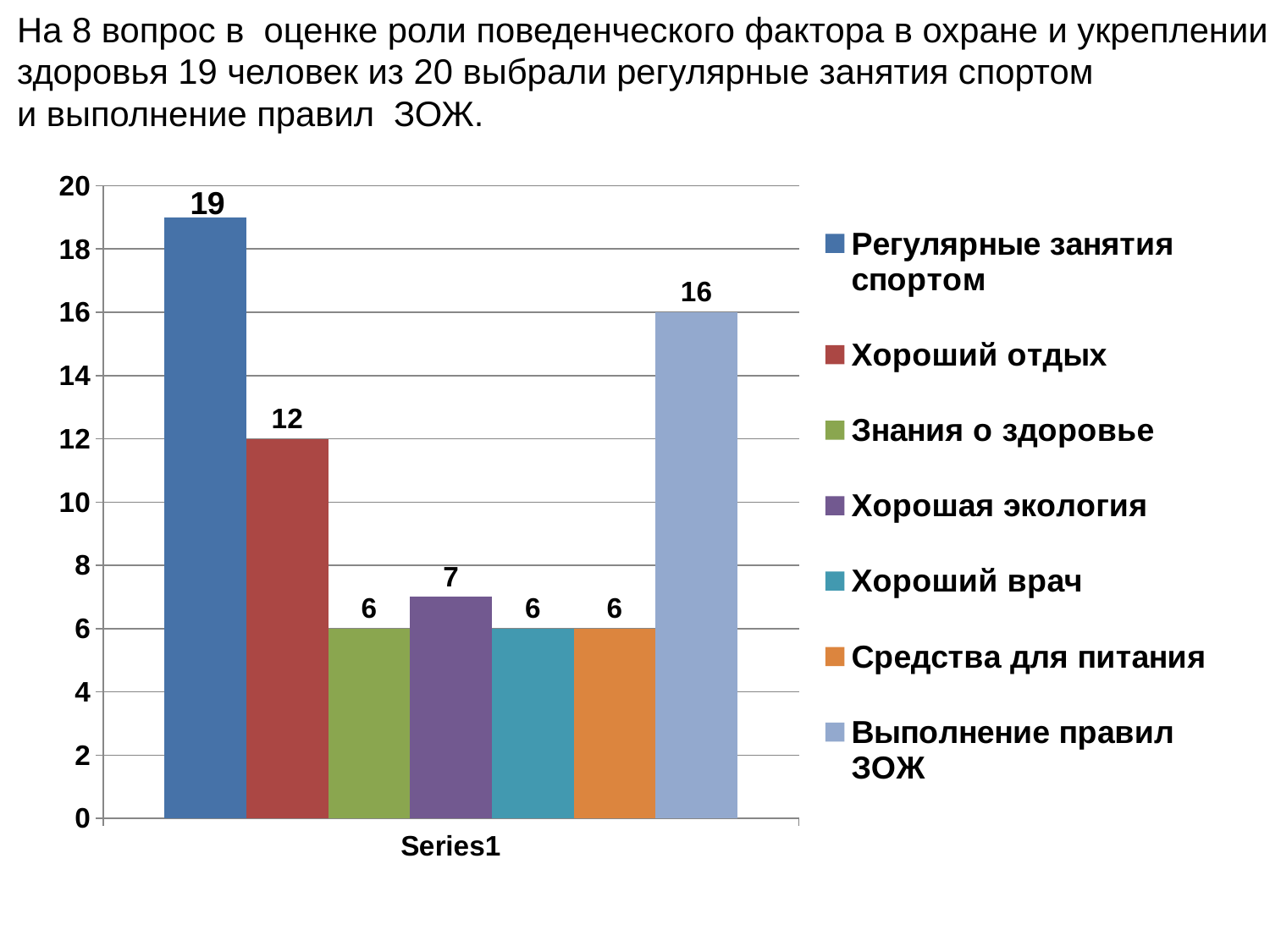
What value is shown for Хороший отдых? 12 What kind of chart is shown on the slide? Bar chart Which legend entry has the highest value? Регулярные занятия спортом How many bars share the value 6? 3 What value is shown for Регулярные занятия спортом? 19 Which is larger, the value for Хороший отдых or the value for Выполнение правил ЗОЖ? Выполнение правил ЗОЖ What is the difference between the values for Регулярные занятия спортом and Выполнение правил ЗОЖ? 3 What value is shown for Хорошая экология? 7 What is the label shown on the horizontal axis of the chart? Series1 What value is shown for Выполнение правил ЗОЖ? 16 What is the difference between the values for Хороший отдых and Хорошая экология? 5 How many entries does the legend list? 7